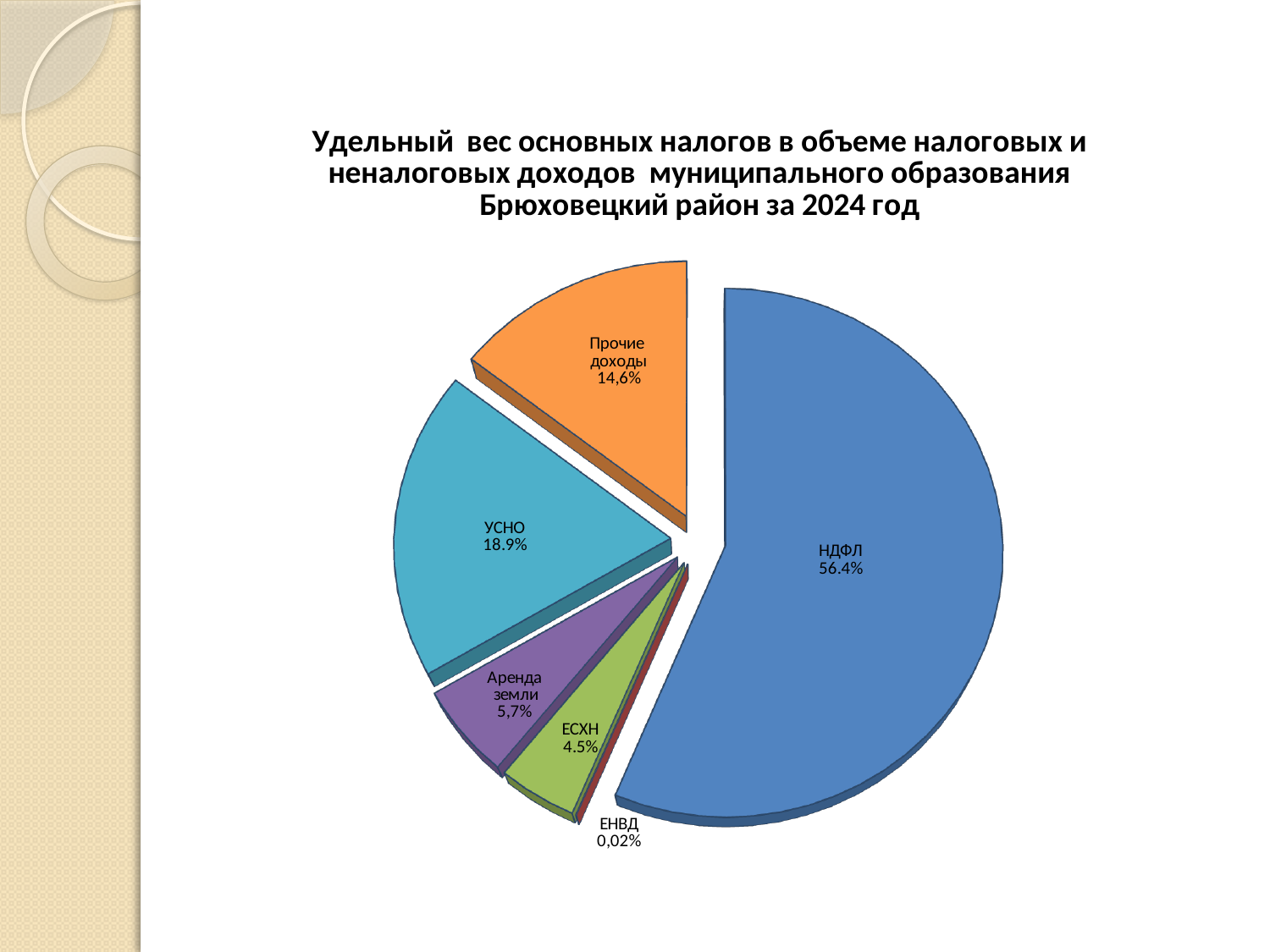
What is the value labelled for ЕНВД? 0,02% What colour is the slice for НДФЛ? Blue What is the value shown for Аренда земли? 5,7% What percentage is labelled for Прочие доходы? 14,6% What share of the pie does НДФЛ account for? 56.4% Which category has the largest share of the pie? НДФЛ Which category has the smallest share of the pie? ЕНВД How many categories (slices) are shown in the pie chart? 6 Which is larger, the share for УСНО or the share for Прочие доходы? УСНО What type of chart is shown on the slide? Pie chart What percentage is shown for ЕСХН? 4.5% What is the value shown for УСНО? 18.9%